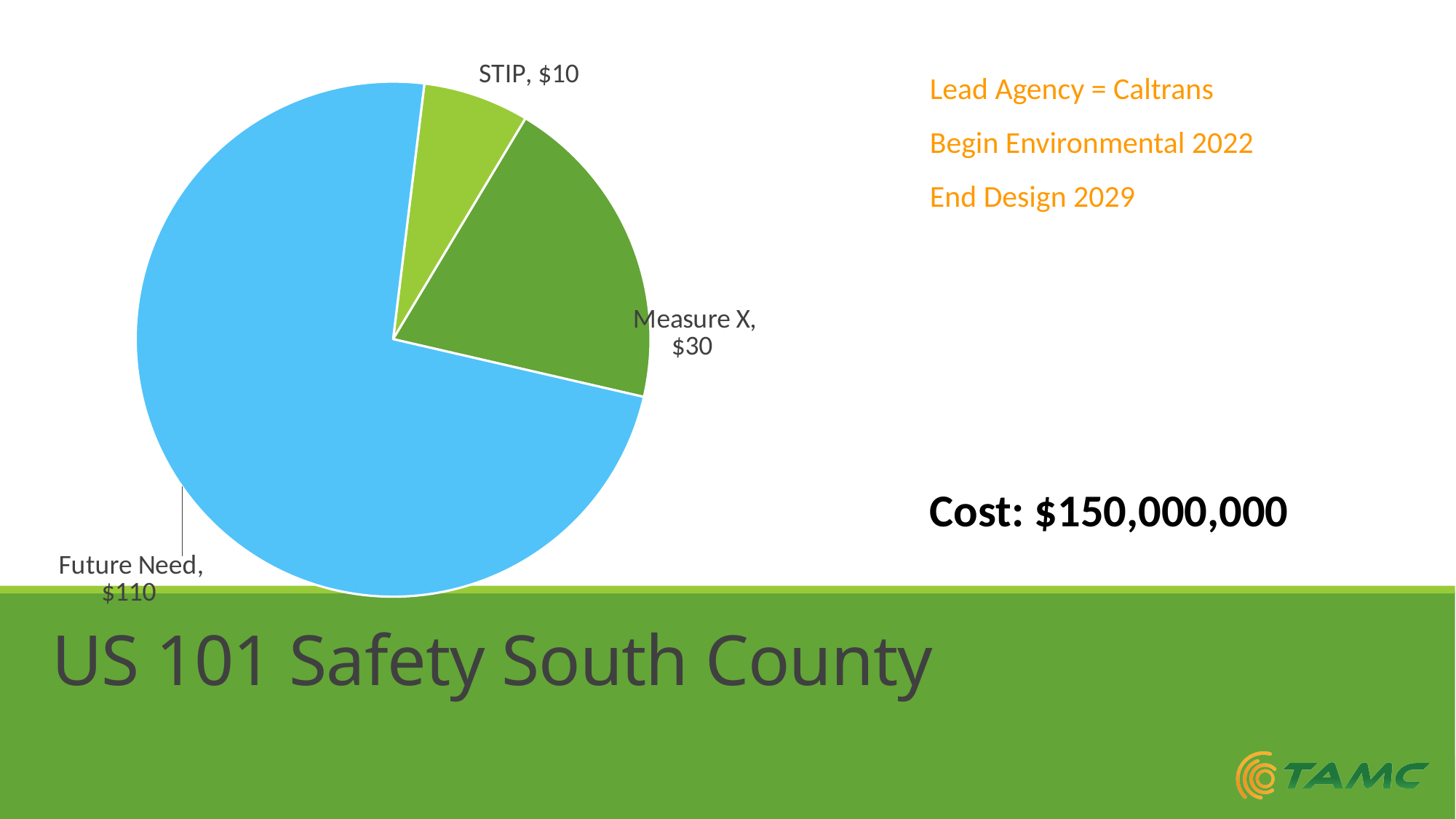
What is the value for Measure X? $30 What is the total of all slices in the pie chart? $150 What colour is the Future Need slice? light blue Which slice of the pie is the largest? Future Need Which is larger, Measure X or STIP? Measure X What is the value for Future Need? $110 What is the difference between the Future Need and Measure X values? $80 What is the value for STIP? $10 How many slices does the pie chart have? 3 What kind of chart is shown on the slide? pie chart Which slice of the pie is the smallest? STIP What is the difference between the Measure X and STIP values? $20